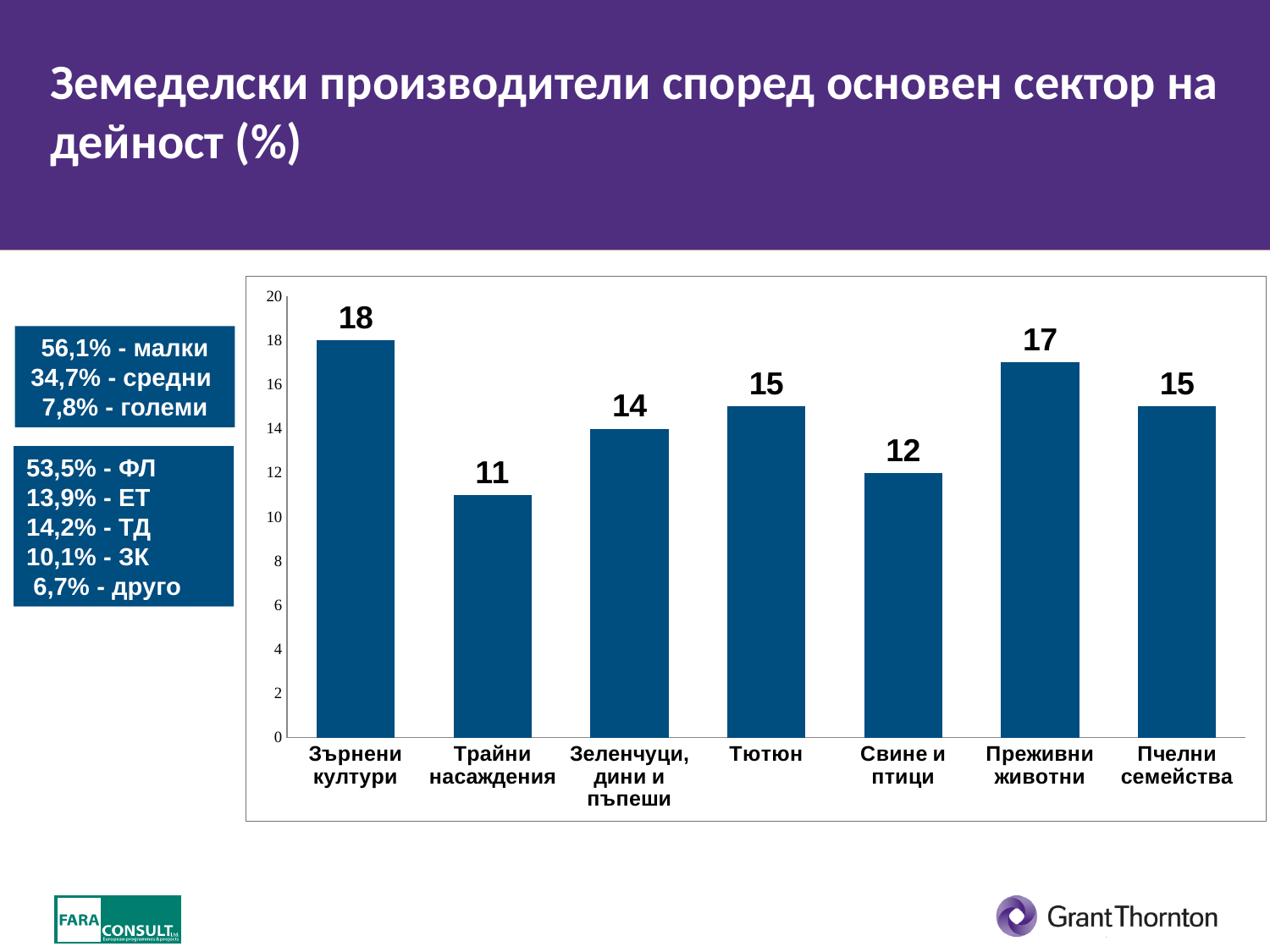
How many categories are shown on the x axis? 7 Which category has the highest value? Зърнени култури What is the value for Свине и птици? 12 What is the value for Трайни насаждения? 11 What kind of chart is shown on the slide? bar chart What is the title of the slide? Земеделски производители според основен сектор на дейност (%) What is the difference between the values for Зърнени култури and Трайни насаждения? 7 What is the value for Зърнени култури? 18 Which is larger, the value for Тютюн or the value for Свине и птици? Тютюн Is the value for Зеленчуци, дини и пъпеши greater or less than 10? greater Which category has the lowest value? Трайни насаждения What is the value for Преживни животни? 17